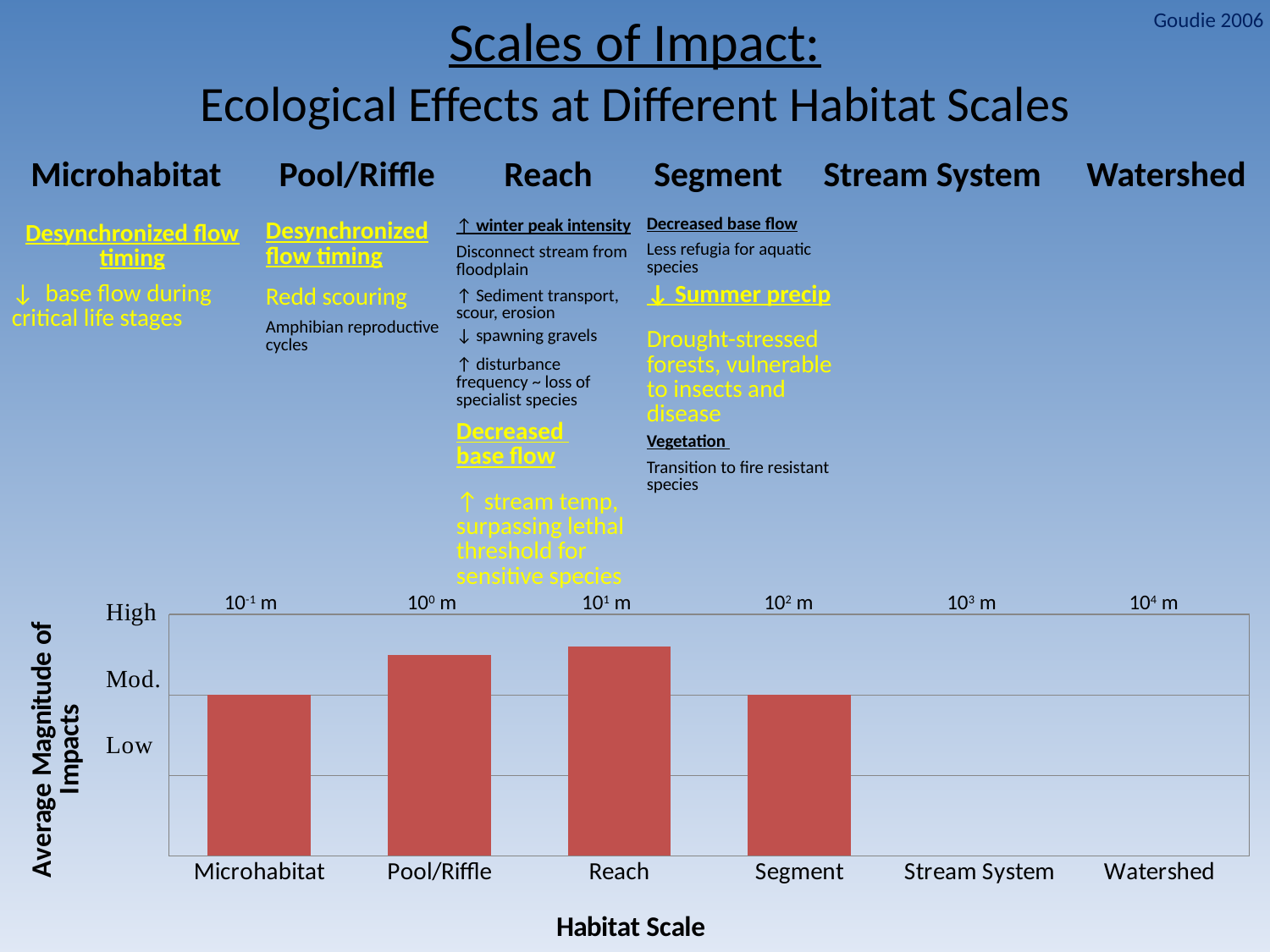
Is the bar for Pool/Riffle taller or shorter than the bar for Segment? Taller Do the bar heights rise or fall from Microhabitat to Reach? Rise Is the bar for Reach taller or shorter than the bar for Microhabitat? Taller What is the title of the x axis of the chart? Habitat Scale Which habitat scales have no visible bar in the chart? Stream System and Watershed What is the title of the y axis of the chart? Average Magnitude of Impacts Which habitat scale has the tallest bar in the chart? Reach Is the bar for Segment above or below the 'High' level on the y axis? Below Is the bar for Reach above or below the 'Mod.' level on the y axis? Above How many habitat scale categories are shown on the x axis of the chart? 6 What kind of chart is shown at the bottom of the slide? Bar chart